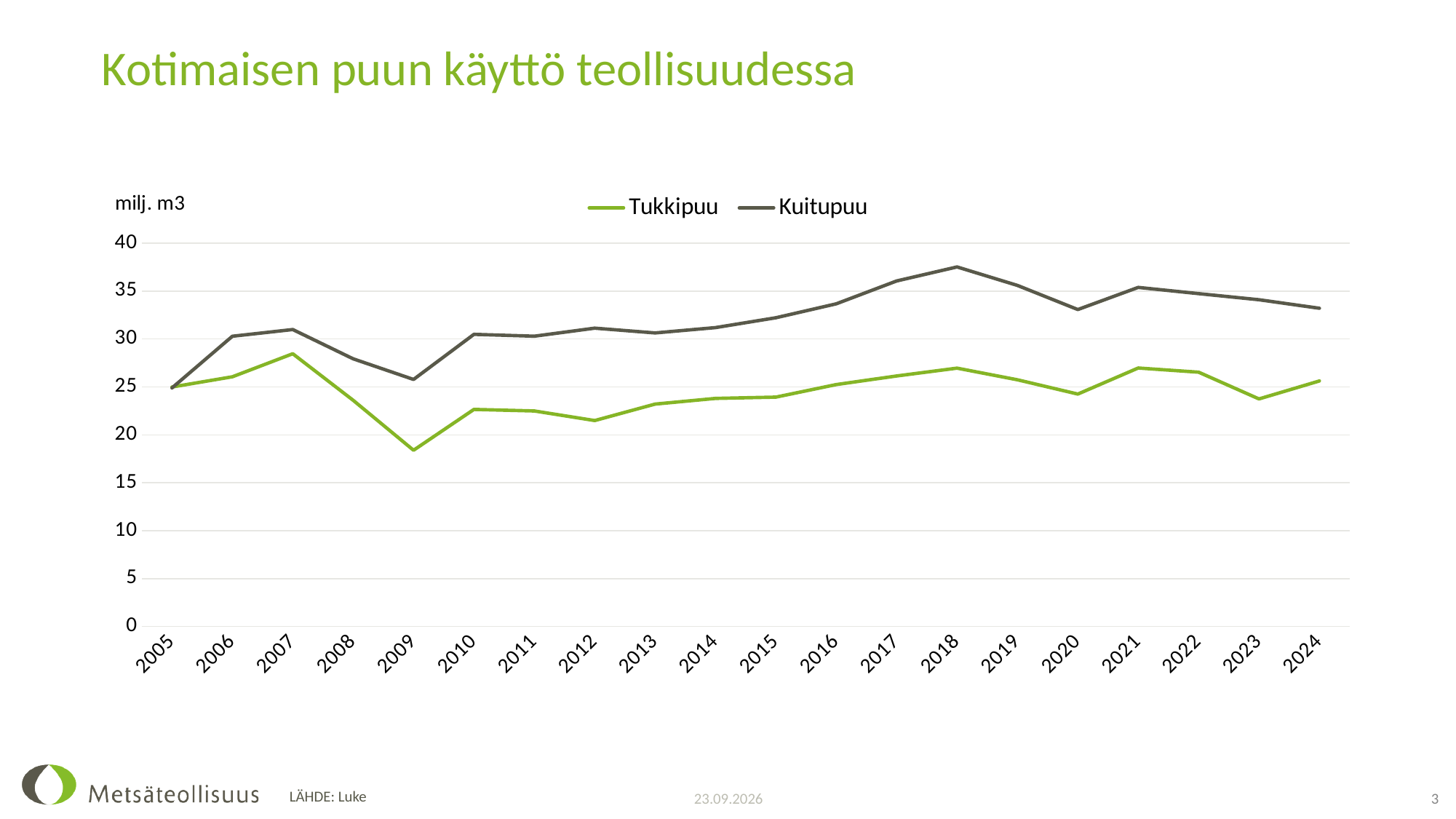
Is the Kuitupuu value for 2018 greater or less than 35? greater Is the Tukkipuu value for 2009 greater or less than 20? less Is the Kuitupuu value for 2020 greater or less than 30? greater How many years are shown on the x axis? 20 What type of chart is shown on the slide? line chart What unit is shown above the y axis? milj. m3 In which year is the Tukkipuu value lowest? 2009 Which series has the larger value in 2015, Tukkipuu or Kuitupuu? Kuitupuu In which year is the Kuitupuu value highest? 2018 Does the Tukkipuu line rise or fall from 2007 to 2009? fall How many series does the legend list? 2